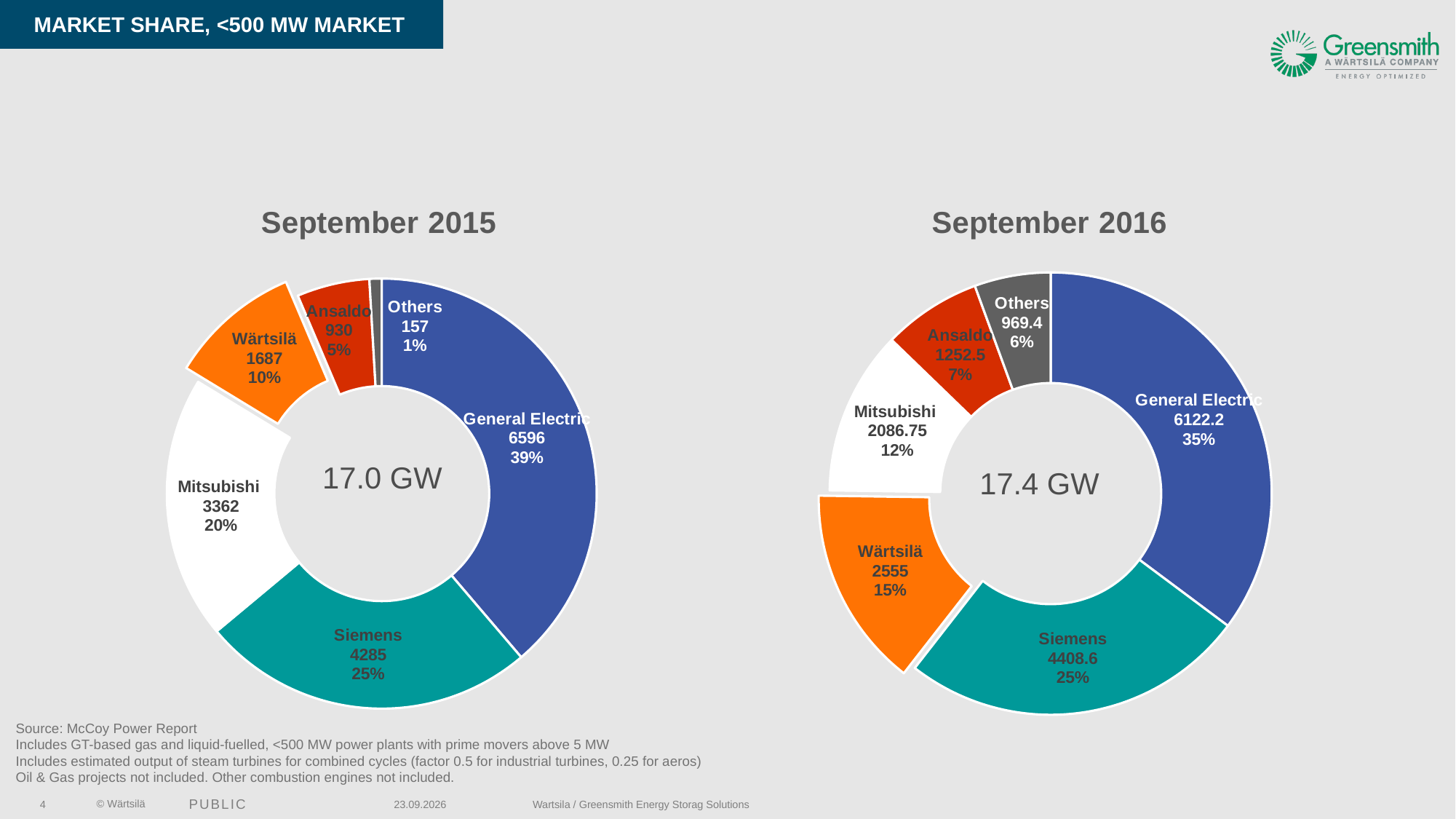
In the September 2015 chart, what value is shown for Ansaldo? 930 What total is shown in the centre of the September 2016 chart? 17.4 GW In the September 2015 chart, which is larger, the value for Mitsubishi or the value for Wärtsilä? Mitsubishi In the September 2016 chart, what is the difference between the values for Siemens and Mitsubishi? 2321.85 In the September 2015 chart, which company has the largest share? General Electric How many segments does the September 2016 chart have? 6 In the September 2016 chart, which segment has the smallest share? Others In the September 2016 chart, what percentage share is shown for Others? 6% In the September 2016 chart, what percentage share is shown for Wärtsilä? 15% In the September 2015 chart, what value is shown for General Electric? 6596 What type of chart is used on this slide? Donut (pie) chart In the September 2015 chart, what is the difference between the values for General Electric and Siemens? 2311